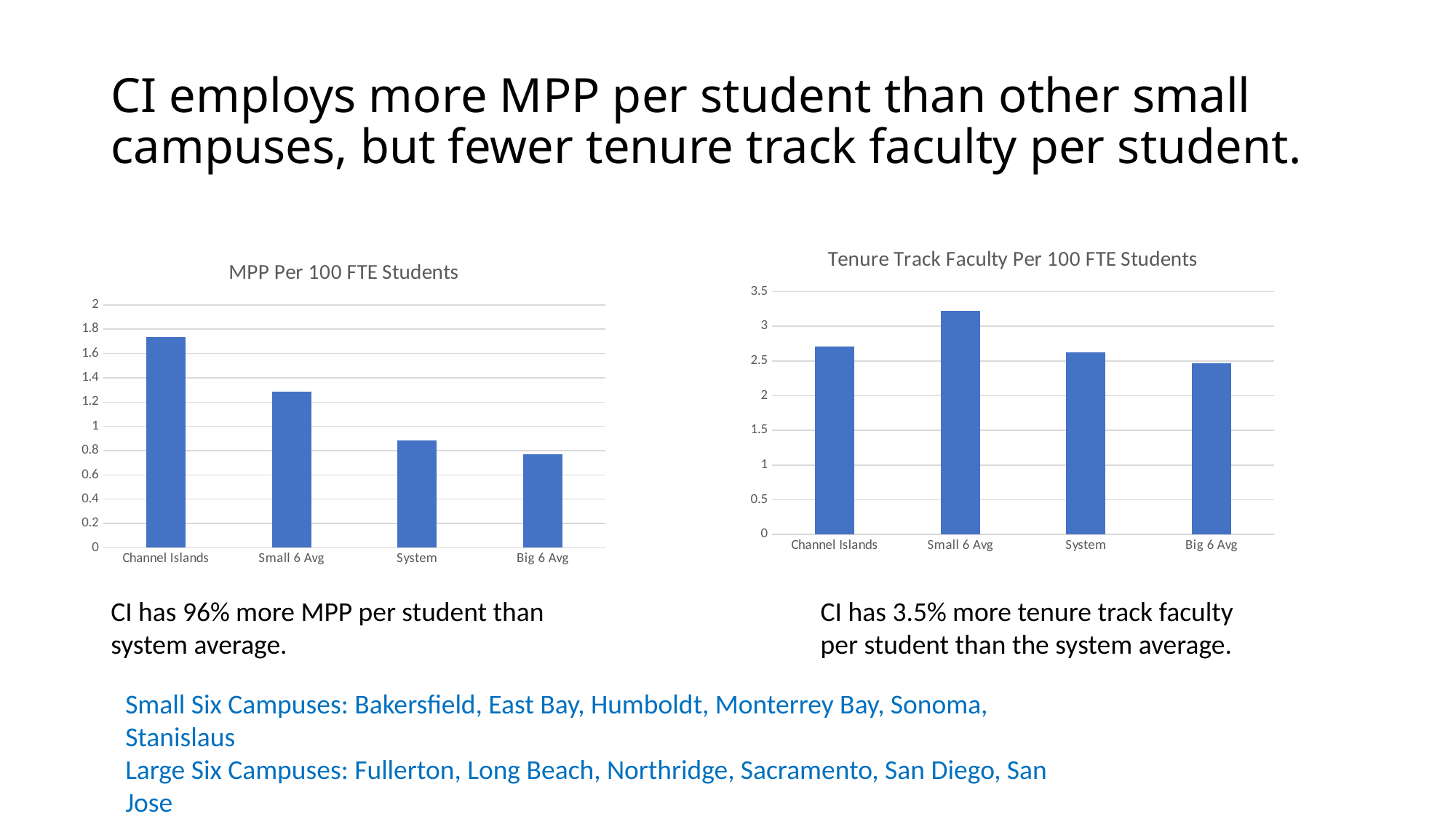
In the MPP Per 100 FTE Students chart, which category has the lowest value? Big 6 Avg In the MPP Per 100 FTE Students chart, do the values rise or fall from left to right? fall In the Tenure Track Faculty Per 100 FTE Students chart, which category has the lowest value? Big 6 Avg In the MPP Per 100 FTE Students chart, is the value for Channel Islands greater or less than 1.6? greater In the MPP Per 100 FTE Students chart, which is larger, Small 6 Avg or Big 6 Avg? Small 6 Avg In the MPP Per 100 FTE Students chart, which category has the highest value? Channel Islands How many categories are shown in the Tenure Track Faculty Per 100 FTE Students chart? 4 In the Tenure Track Faculty Per 100 FTE Students chart, is the value for Small 6 Avg greater or less than 3? greater What kind of chart is the MPP Per 100 FTE Students chart? bar chart In the Tenure Track Faculty Per 100 FTE Students chart, which category has the highest value? Small 6 Avg In the MPP Per 100 FTE Students chart, is the value for System greater or less than 1? less